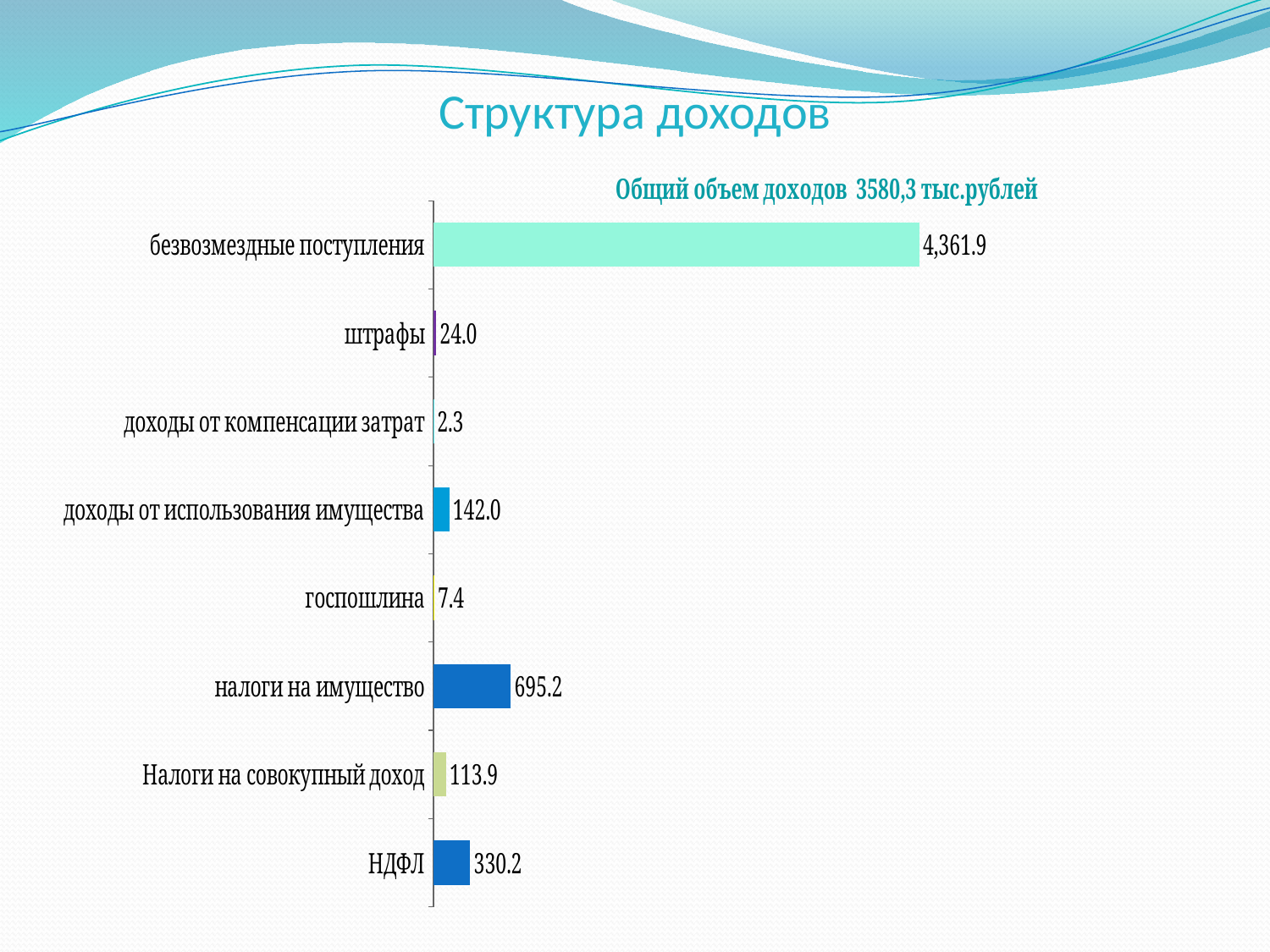
What is the difference between доходы от использования имущества and Налоги на совокупный доход? 28.1 What type of chart is shown on the slide? bar chart Which category has the lowest value? доходы от компенсации затрат Which category has the highest value? безвозмездные поступления What is the value for НДФЛ? 330.2 What total income amount is stated in the text above the chart? 3580,3 тыс.рублей How many categories are shown in the chart? 8 What is the value for налоги на имущество? 695.2 What is the value for штрафы? 24.0 Which is larger, госпошлина or штрафы? штрафы What is the difference between налоги на имущество and НДФЛ? 365.0 What is the value for доходы от использования имущества? 142.0